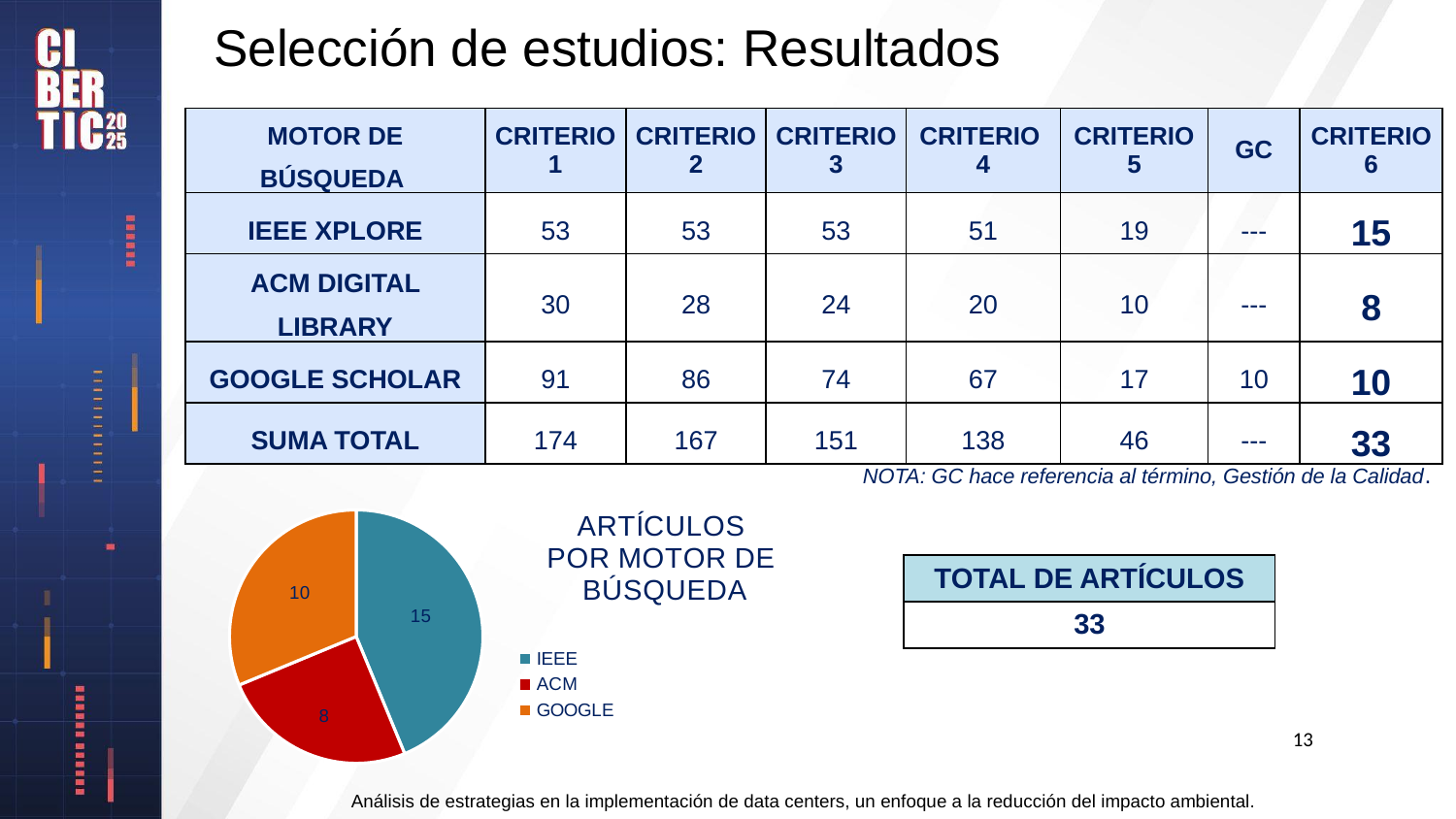
How many entries does the pie chart legend list? 3 How many slices does the pie chart have? 3 What type of chart is shown on the slide? pie chart In the pie chart, which is larger, the GOOGLE slice or the ACM slice? GOOGLE What is the title of the pie chart? ARTÍCULOS POR MOTOR DE BÚSQUEDA What is the total of all the slices in the pie chart? 33 Which search engine has the smallest slice in the pie chart? ACM In the pie chart, how many articles are attributed to ACM? 8 Which search engine has the largest slice in the pie chart? IEEE In the pie chart, how many articles are attributed to IEEE? 15 In the pie chart, how many articles are attributed to GOOGLE? 10 What is the difference between the IEEE and ACM values in the pie chart? 7